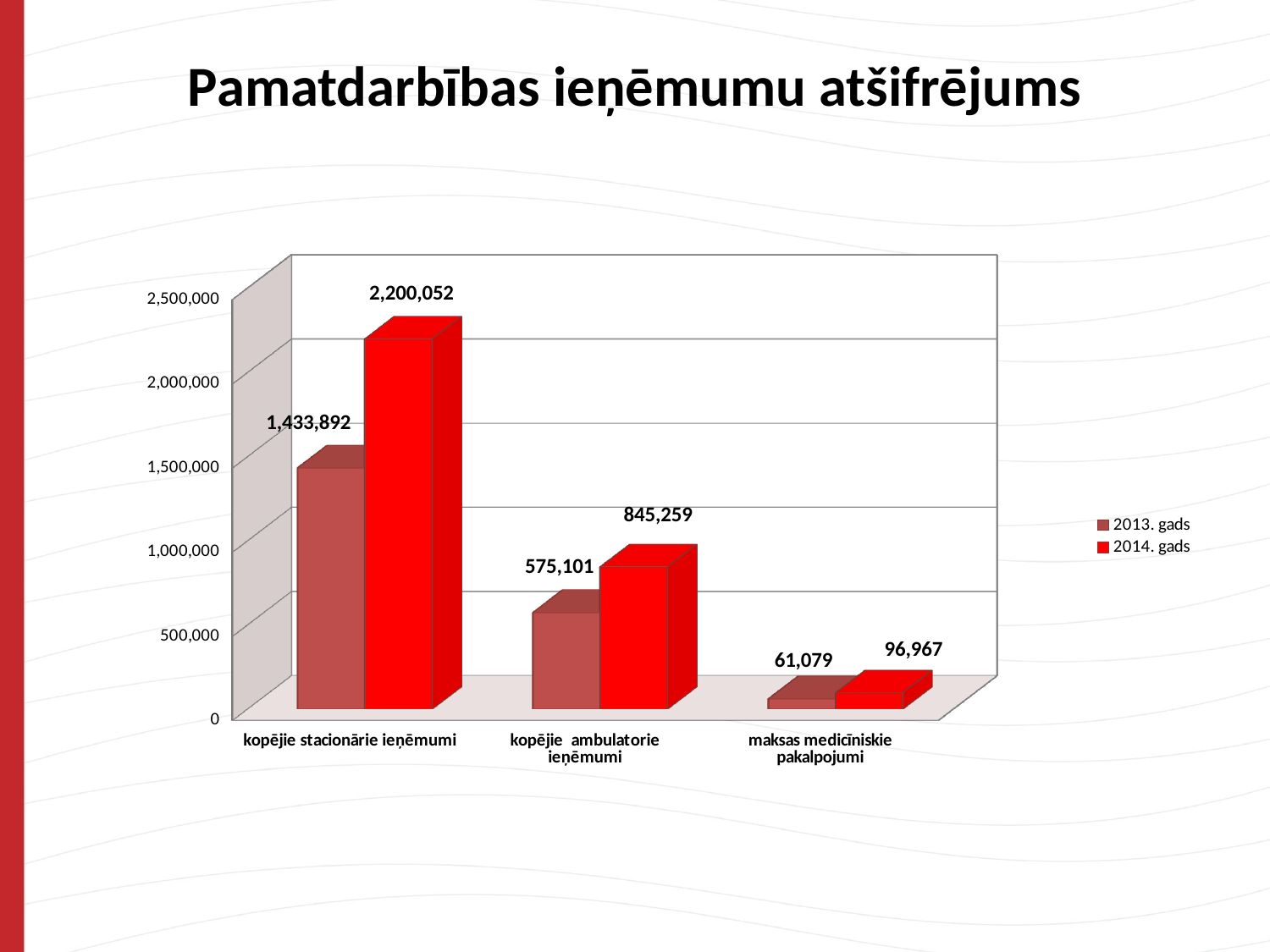
What is the value for kopējie ambulatorie ieņēmumi in 2014. gads? 845,259 Which is larger: the 2013. gads value for kopējie ambulatorie ieņēmumi or the 2014. gads value for maksas medicīniskie pakalpojumi? 2013. gads value for kopējie ambulatorie ieņēmumi What is the value for kopējie stacionārie ieņēmumi in 2014. gads? 2,200,052 What is the difference between the 2014. gads and 2013. gads values for kopējie ambulatorie ieņēmumi? 270,158 What kind of chart is shown on the slide? bar chart What is the difference between the 2014. gads and 2013. gads values for kopējie stacionārie ieņēmumi? 766,160 Which category has the lowest value in 2013. gads? maksas medicīniskie pakalpojumi Which category has the highest value in 2014. gads? kopējie stacionārie ieņēmumi How many series does the legend list? 2 What is the value for maksas medicīniskie pakalpojumi in 2013. gads? 61,079 How many categories are shown on the x axis? 3 What is the value for kopējie stacionārie ieņēmumi in 2013. gads? 1,433,892